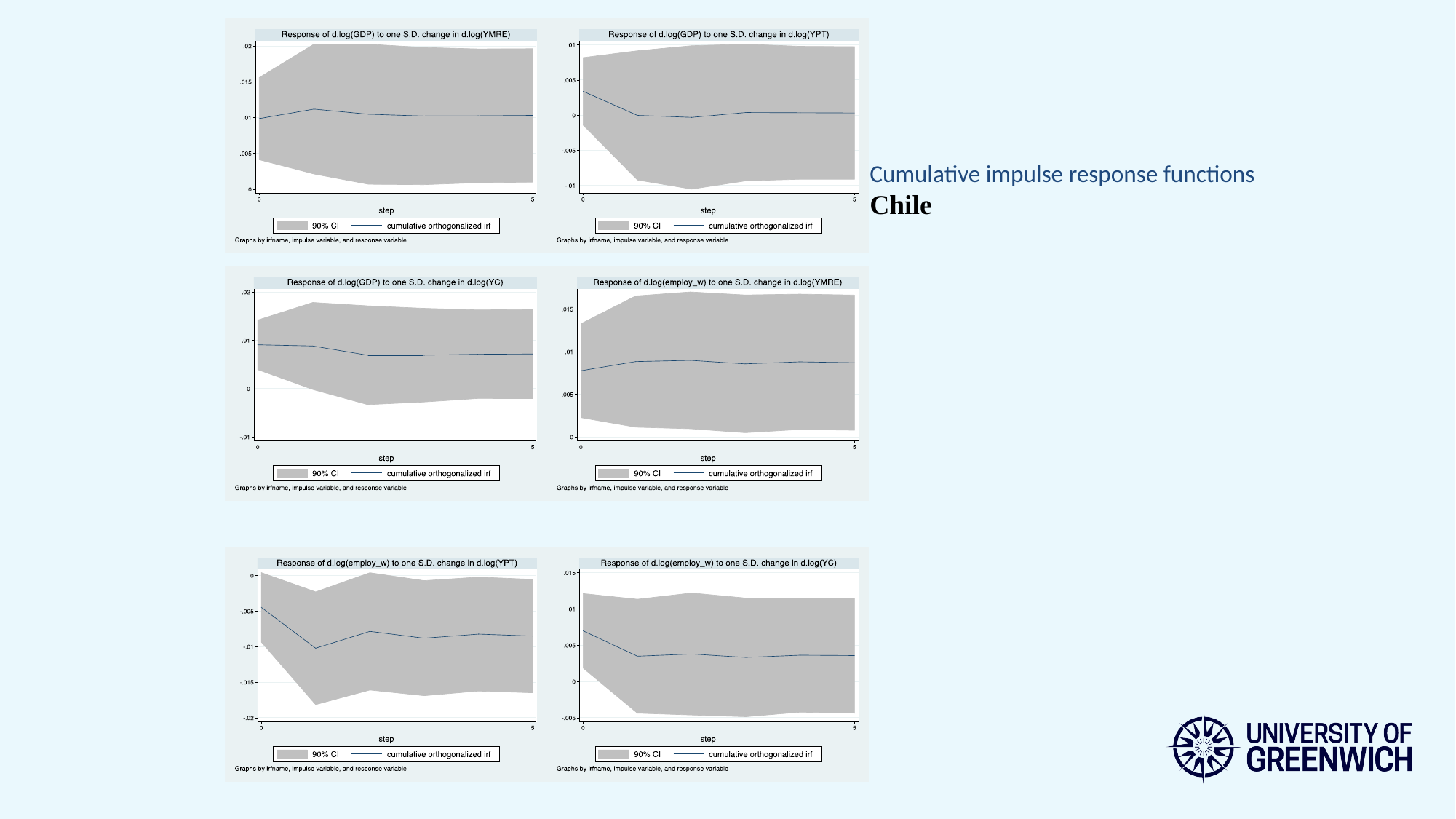
How many charts are shown on the slide? 6 In the bottom-right chart, 'Response of d.log(employ_w) to one S.D. change in d.log(YC)', is the value of the cumulative orthogonalized irf at step 5 greater or less than .005? less In the top-left chart, 'Response of d.log(GDP) to one S.D. change in d.log(YMRE)', is the value of the cumulative orthogonalized irf at step 0 greater or less than .005? greater How many entries does the legend of the top-left chart list? 2 According to the legend of the top-left chart, what does the grey shaded area represent? 90% CI In the bottom-right chart, 'Response of d.log(employ_w) to one S.D. change in d.log(YC)', is the value of the cumulative orthogonalized irf at step 0 greater or less than .005? greater What kind of chart is the top-left chart, 'Response of d.log(GDP) to one S.D. change in d.log(YMRE)'? Line chart In the top-right chart, 'Response of d.log(GDP) to one S.D. change in d.log(YPT)', does the cumulative orthogonalized irf rise or fall from step 0 to step 1? fall In the bottom-left chart, 'Response of d.log(employ_w) to one S.D. change in d.log(YPT)', does the cumulative orthogonalized irf rise or fall from step 0 to step 1? fall